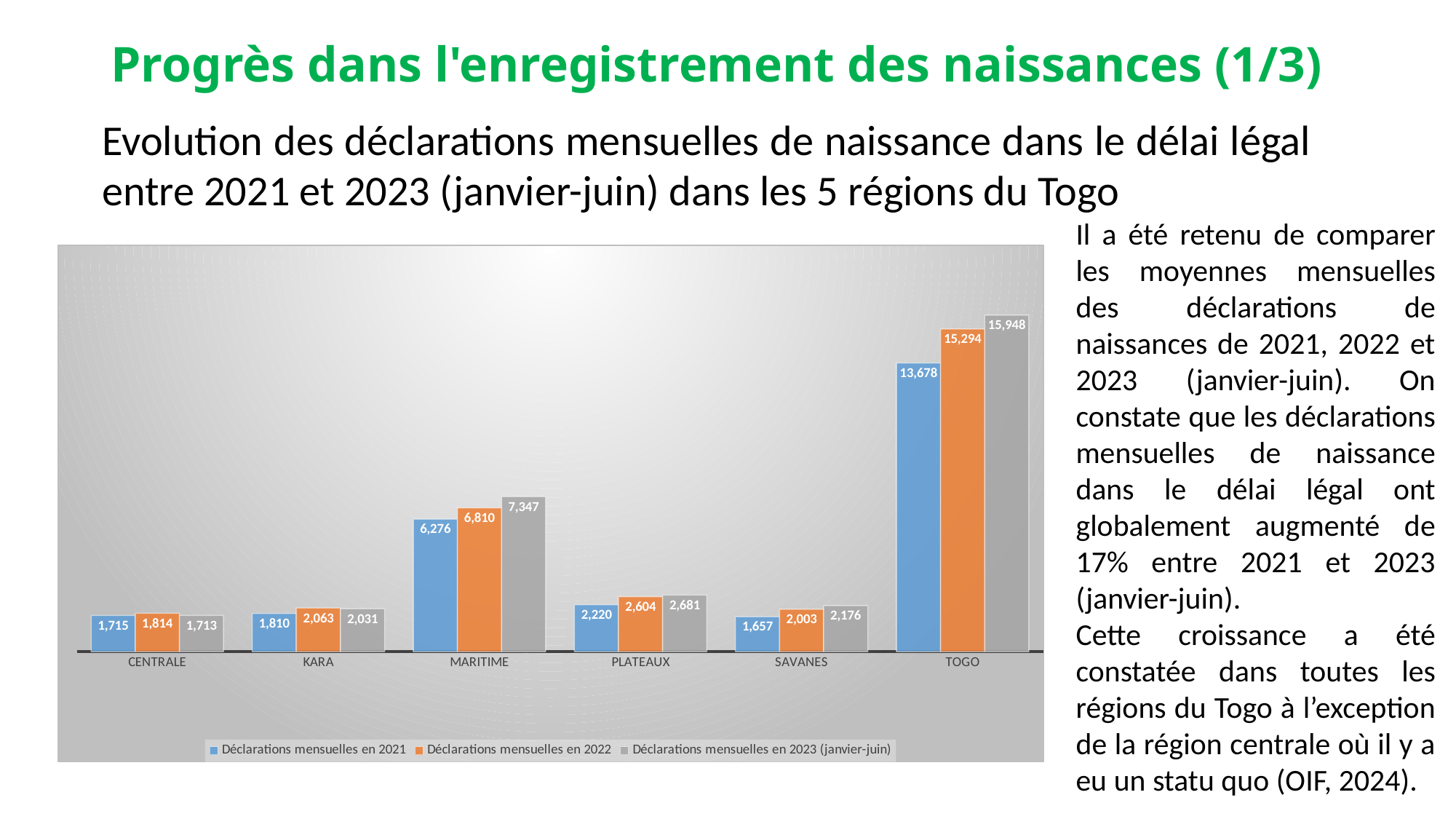
What is the value of 'Déclarations mensuelles en 2022' for SAVANES? 2,003 Which category has the lowest value for 'Déclarations mensuelles en 2021'? SAVANES What is the value of 'Déclarations mensuelles en 2023 (janvier-juin)' for TOGO? 15,948 For CENTRALE, which is larger: the 2021 value or the 2022 value? 2022 (1,814) What is the difference between the 2023 (janvier-juin) and 2021 values for MARITIME? 1,071 Which category has the highest value for 'Déclarations mensuelles en 2022'? TOGO Which colour represents 'Déclarations mensuelles en 2022' in the chart? Orange How many categories are shown on the x axis? 6 What is the value of 'Déclarations mensuelles en 2021' for MARITIME? 6,276 What is the difference between the 2022 and 2021 values for PLATEAUX? 384 How many series does the legend list? 3 What kind of chart is shown on the slide? Bar chart